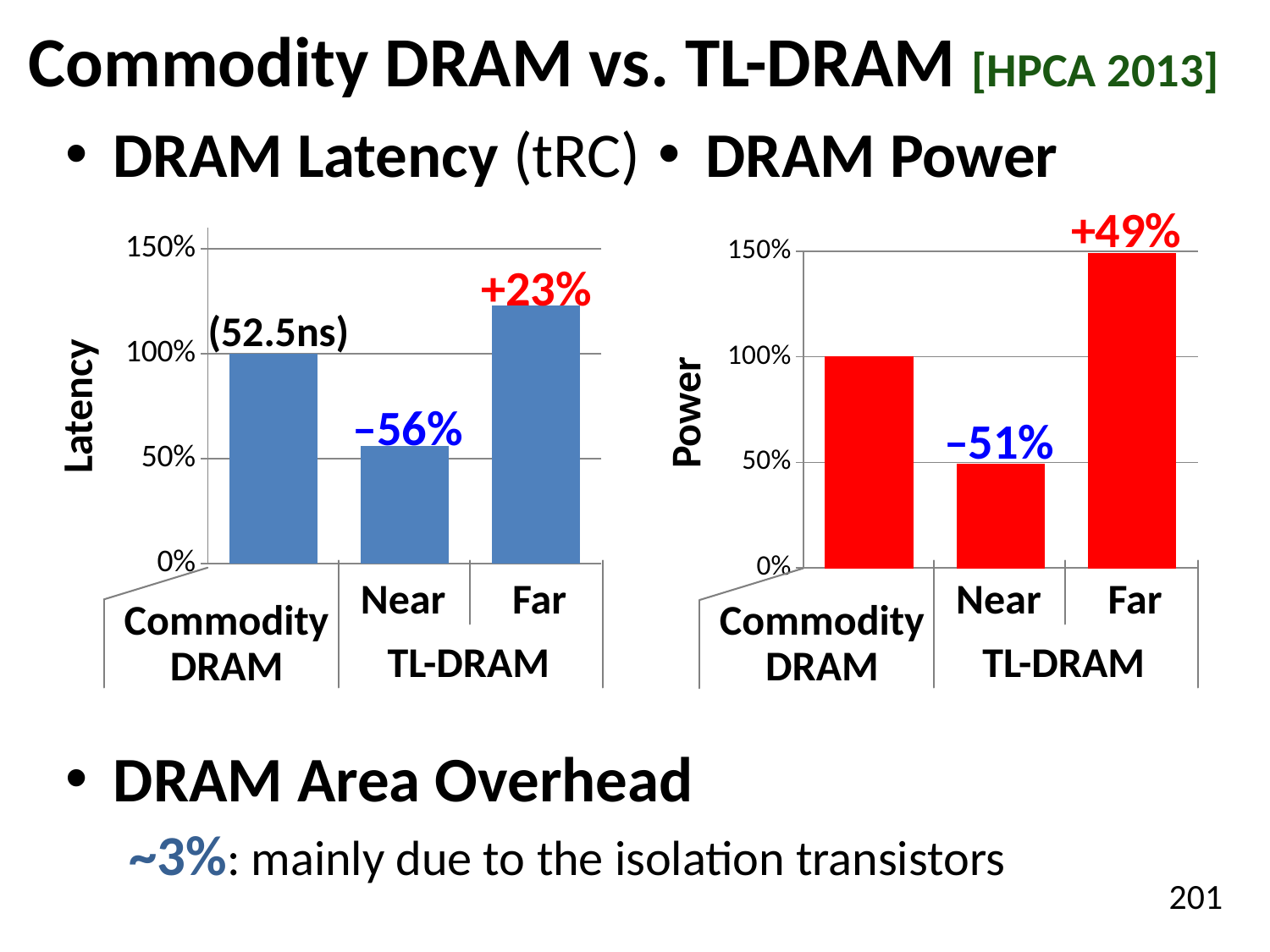
In the DRAM Power chart, which is larger, the Commodity DRAM bar or the Near bar? Commodity DRAM In the DRAM Latency chart, is the value for Far greater or less than 100%? greater What type of chart is the DRAM Latency chart? bar chart How many bars are plotted in the DRAM Power chart? 3 In the DRAM Power chart, what percentage change is labelled above the Near bar? –51% In the DRAM Latency chart, what percentage change is labelled above the Near bar? –56% In the DRAM Latency chart, what percentage change is labelled above the Far bar? +23% In the DRAM Latency chart, what absolute latency is shown in parentheses for Commodity DRAM? 52.5ns In the DRAM Power chart, what percentage change is labelled above the Far bar? +49% In the DRAM Latency chart, what is the value of the Commodity DRAM bar? 100% In the DRAM Power chart, which bar is the highest? Far In the DRAM Latency chart, which bar is the lowest? Near